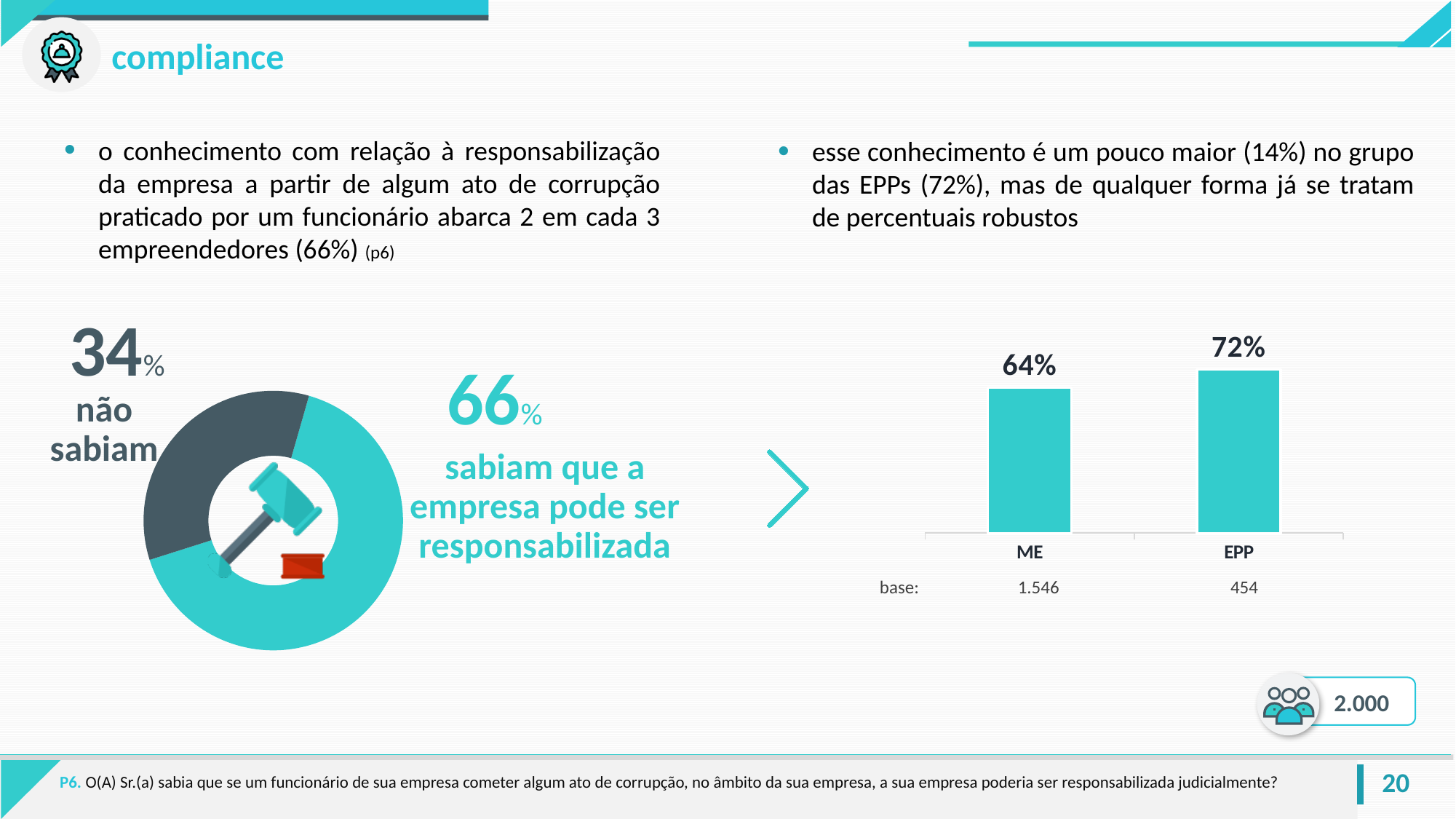
In the bar chart on the right, what is the base (sample size) shown for ME? 1.546 In the bar chart on the right, how many categories are shown? 2 In the bar chart on the right, what is the difference between the EPP and ME values? 8% In the bar chart on the right, what is the base (sample size) shown for EPP? 454 In the donut chart on the left, what share of respondents did not know (não sabiam)? 34% What kind of chart is shown on the right side of the slide? Bar chart In the bar chart on the right, what is the value for ME? 64% In the bar chart on the right, which category has the higher value? EPP In the donut chart on the left, what share of respondents knew the company could be held responsible? 66% In the bar chart on the right, which category has the lower value? ME What kind of chart is shown on the left side of the slide? Donut (pie) chart In the bar chart on the right, what is the value for EPP? 72%